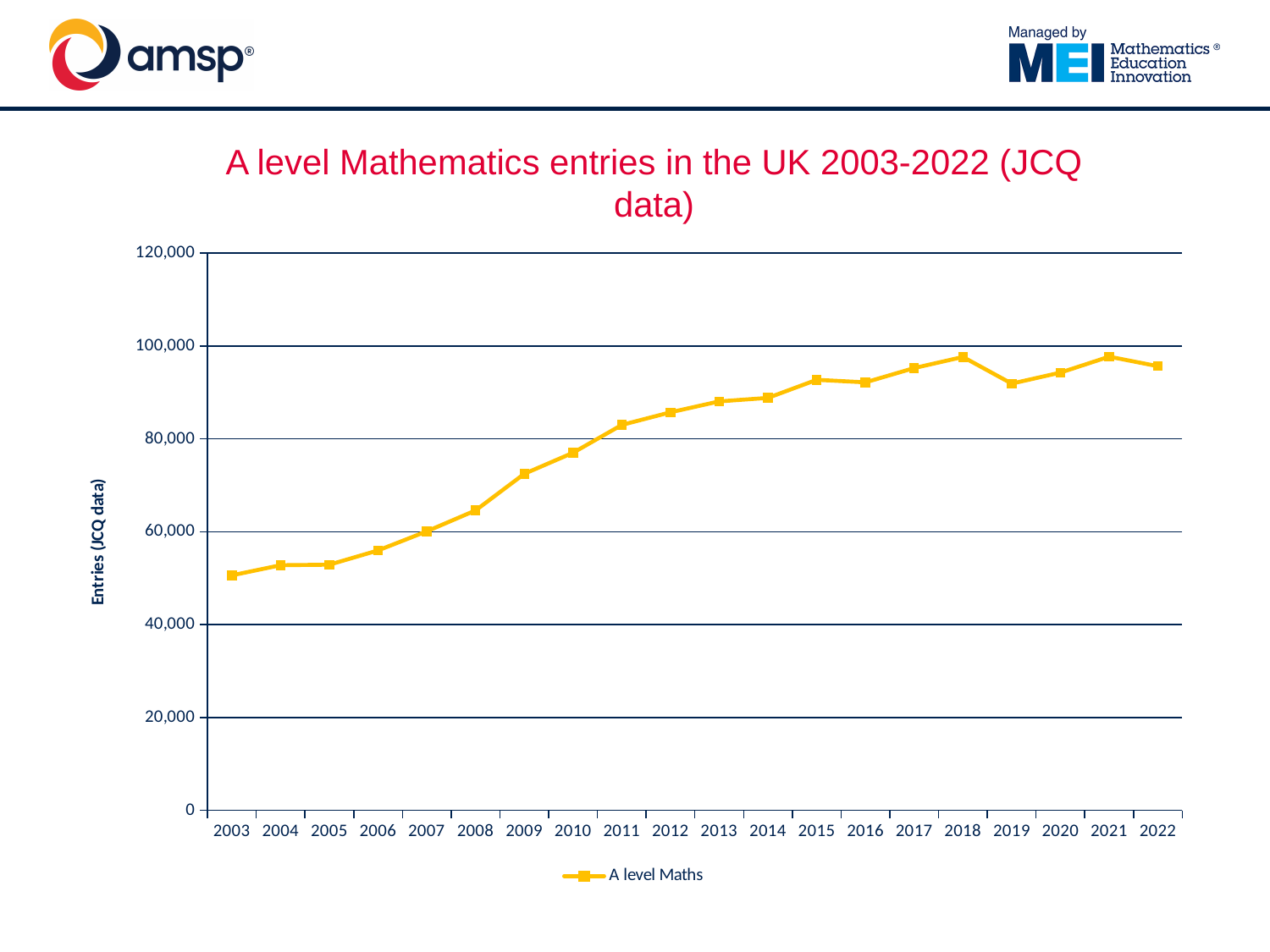
Is the value for 2003 greater or less than 60,000? less How many series does the legend list? 1 Which year has more A level Maths entries, 2008 or 2012? 2012 What kind of chart is shown on the slide? Line chart How many years are plotted on the x axis? 20 Which year has more A level Maths entries, 2018 or 2019? 2018 Which year has the lowest number of A level Maths entries? 2003 Is the value for 2011 greater or less than 80,000? greater Do A level Maths entries generally rise or fall from 2003 to 2022? Rise Is the value for 2018 greater or less than 100,000? less What is the title of the chart? A level Mathematics entries in the UK 2003-2022 (JCQ data) What is the name of the series shown in the legend? A level Maths